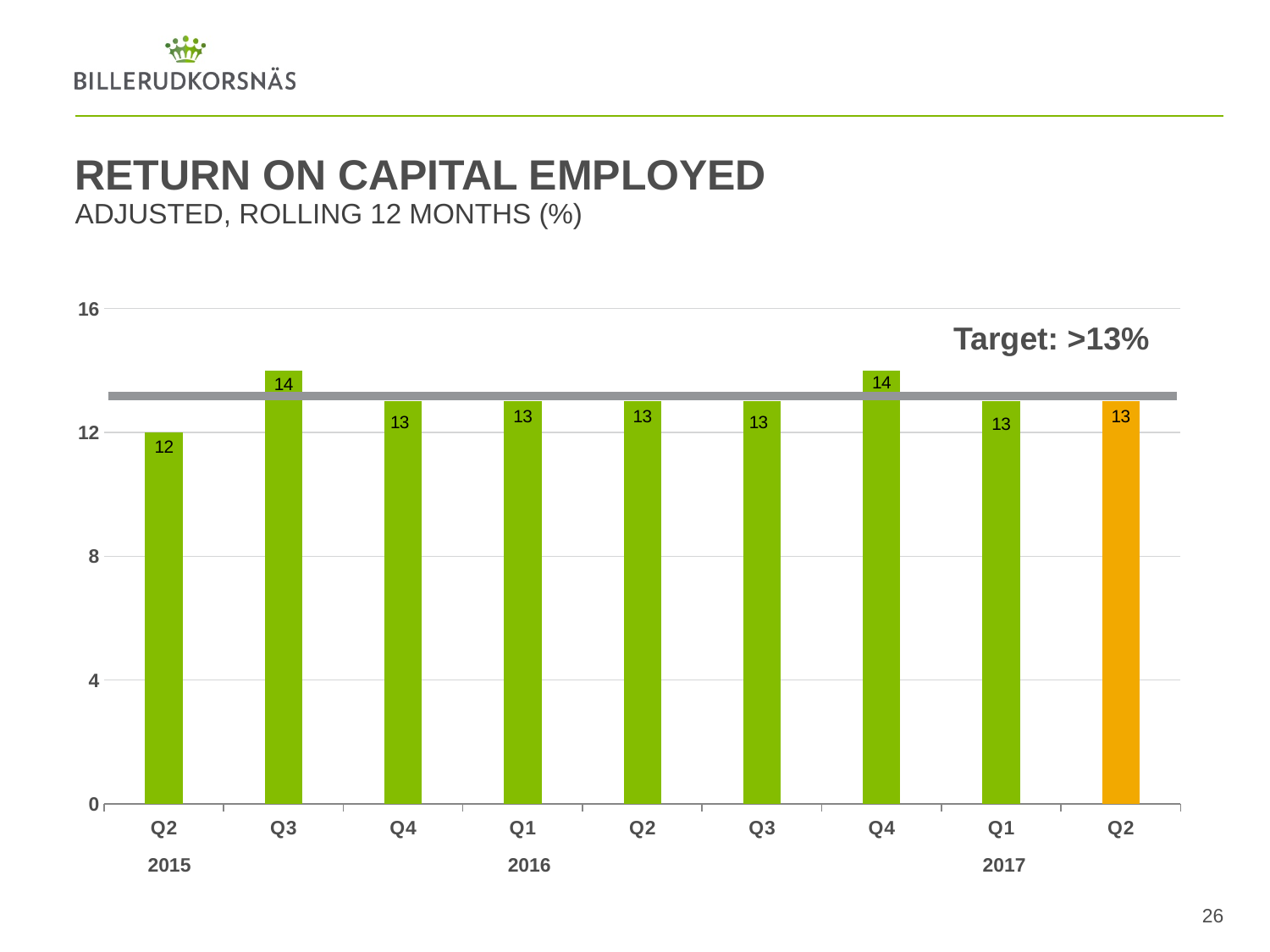
What kind of chart is shown on the slide? bar chart Which is larger, the value for Q4 2016 or the value for Q1 2017? Q4 2016 What is the difference between the values for Q3 2015 and Q2 2015? 2 Which quarter has the lowest value? Q2 2015 What is the value for Q2 2017? 13 What target is stated on the chart? >13% Which bar is coloured orange instead of green? Q2 2017 What is the value for Q4 2016? 14 What is the value for Q3 2015? 14 Is the value for Q2 2015 greater or less than 8? greater How many quarters are plotted on the chart? 9 What is the value for Q2 2015? 12